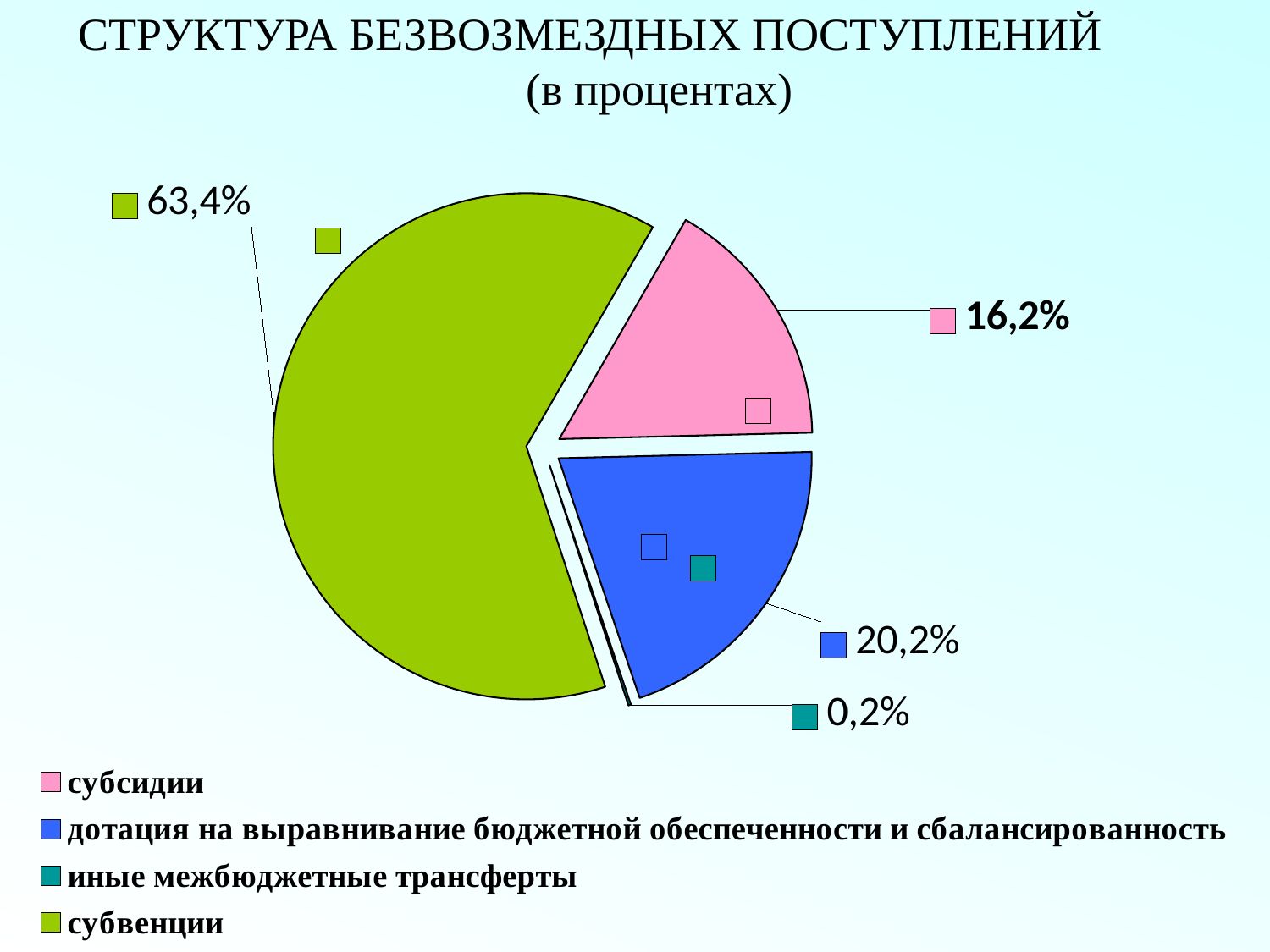
What is the difference between the shares for дотация на выравнивание бюджетной обеспеченности и сбалансированность and субсидии? 4,0% Which category has the smallest share of the pie? иные межбюджетные трансферты Which category has the largest share of the pie? субвенции What is the share for субвенции? 63,4% What is the share for субсидии? 16,2% What colour is the slice for субсидии? pink What is the share for дотация на выравнивание бюджетной обеспеченности и сбалансированность? 20,2% What is the difference between the shares for субвенции and субсидии? 47,2% What kind of chart is shown on the slide? pie chart What is the share for иные межбюджетные трансферты? 0,2% How many slices does the pie chart have? 4 Which is larger, the share for субсидии or the share for дотация на выравнивание бюджетной обеспеченности и сбалансированность? дотация на выравнивание бюджетной обеспеченности и сбалансированность